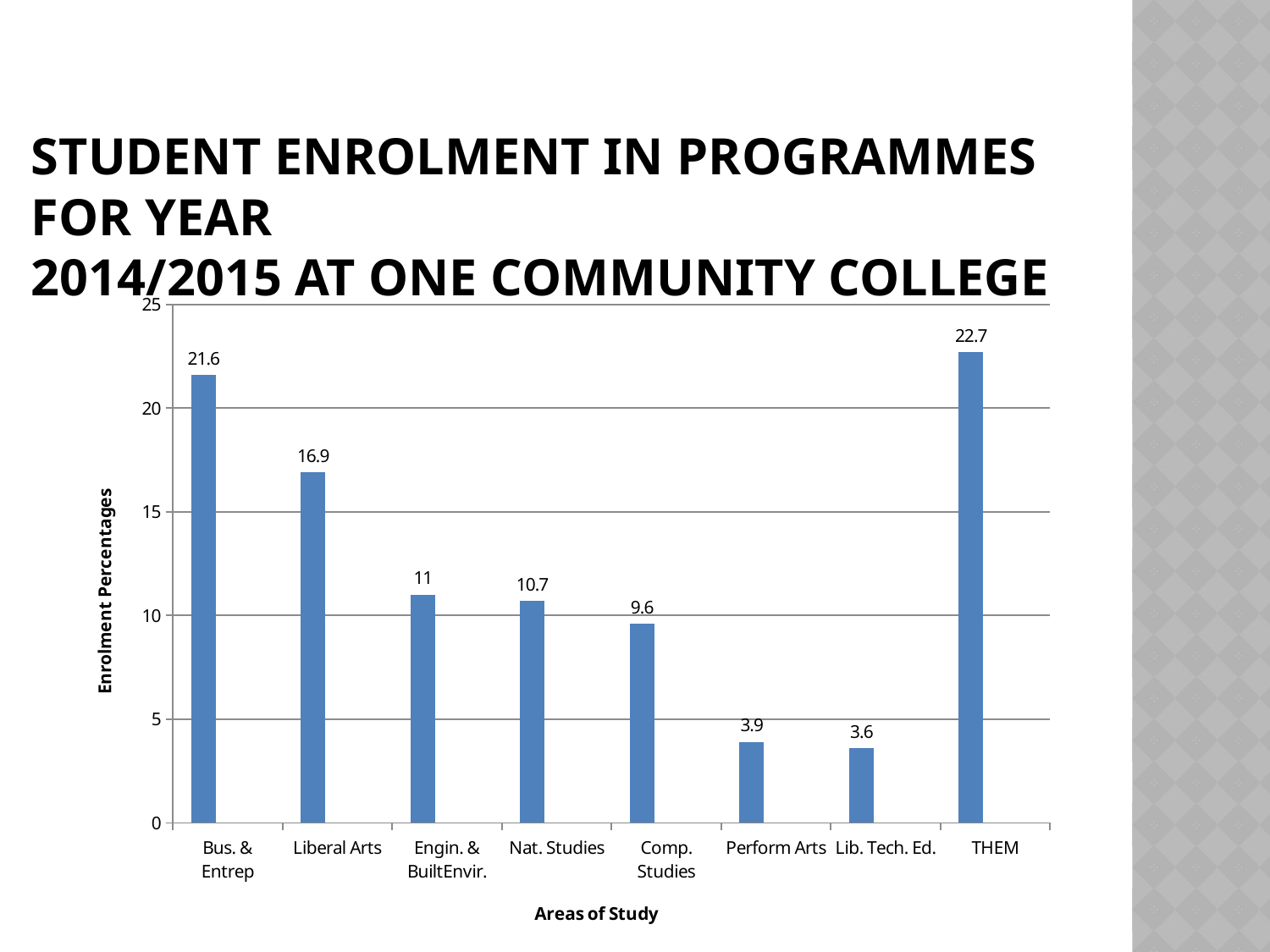
What is the enrolment percentage for Lib. Tech. Ed.? 3.6 Which has a higher enrolment percentage, Liberal Arts or Engin. & BuiltEnvir.? Liberal Arts What kind of chart is shown on the slide? bar chart What is the enrolment percentage for Comp. Studies? 9.6 Which area of study has the highest enrolment percentage? THEM What is the label of the vertical axis? Enrolment Percentages What is the difference between the enrolment percentages for Engin. & BuiltEnvir. and Nat. Studies? 0.3 Which area of study has the lowest enrolment percentage? Lib. Tech. Ed. Is the value for Perform Arts greater or less than 5? less How many areas of study are shown on the x axis? 8 What is the enrolment percentage for Liberal Arts? 16.9 What is the difference between the enrolment percentages for THEM and Bus. & Entrep? 1.1